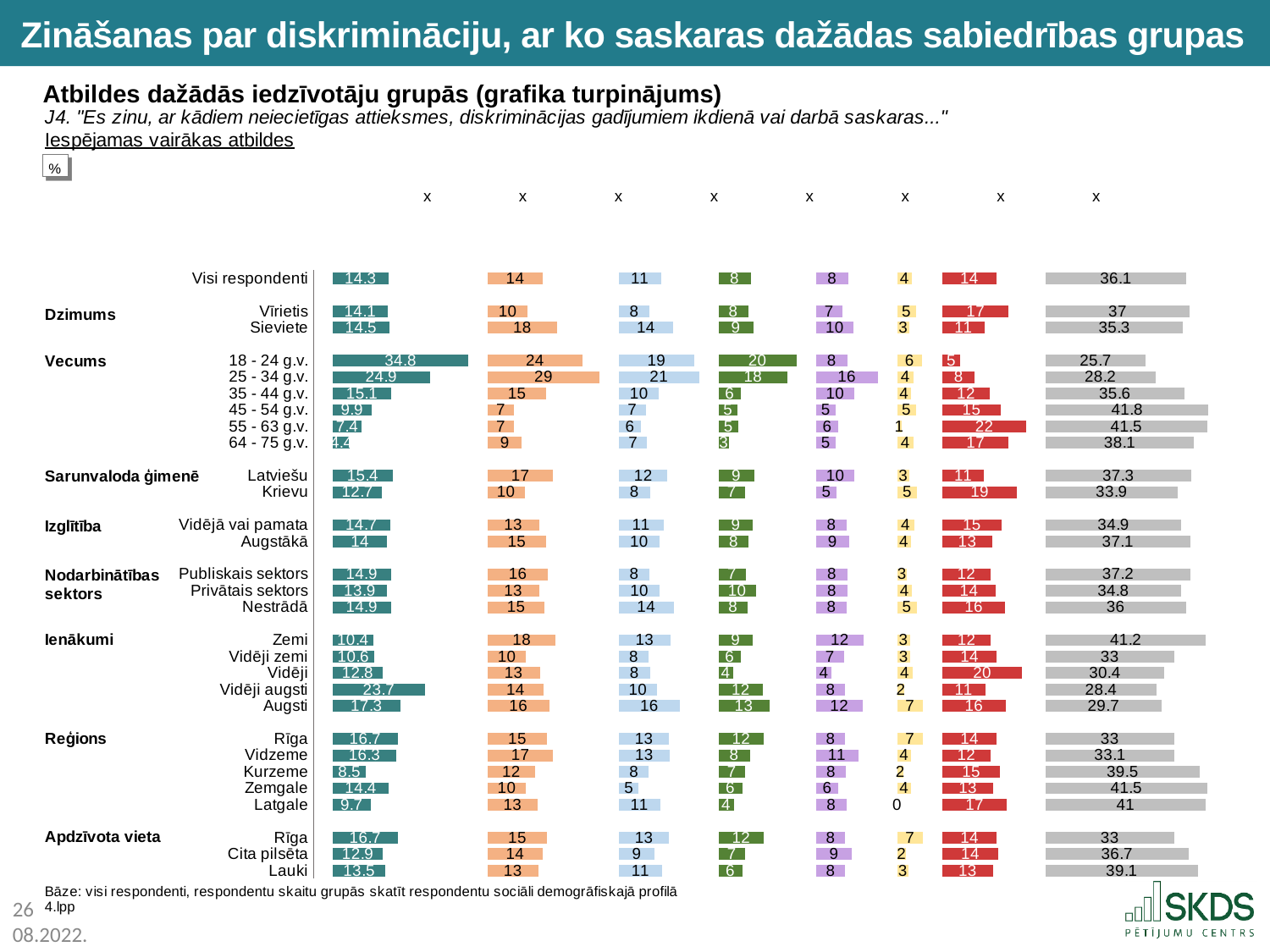
What kind of chart is shown on the slide? Bar chart In the last (grey) column of bars, which region under Reģions has the highest value? Zemgale In the first (teal) column of bars, which age group under Vecums has the highest value? 18 - 24 g.v. In the first (teal) column of bars, do the values rise or fall as the age group goes from 18 - 24 g.v. to 64 - 75 g.v.? Fall In the first (teal) column of bars, which age group under Vecums has the lowest value? 64 - 75 g.v. In the first (teal) column of bars, what is the value for Visi respondenti? 14.3 How many columns of bars (series) are shown on the chart? 8 In the second (orange) column of bars, what is the value for 25 - 34 g.v.? 29 In the last (grey) column of bars, which is larger: the value for Latviešu or for Krievu? Latviešu In the last (grey) column of bars, what is the value for Visi respondenti? 36.1 In the last (grey) column of bars, what is the value for Zemi under Ienākumi? 41.2 In the first (teal) column of bars, what is the difference between the values for Sieviete and Vīrietis? 0.4